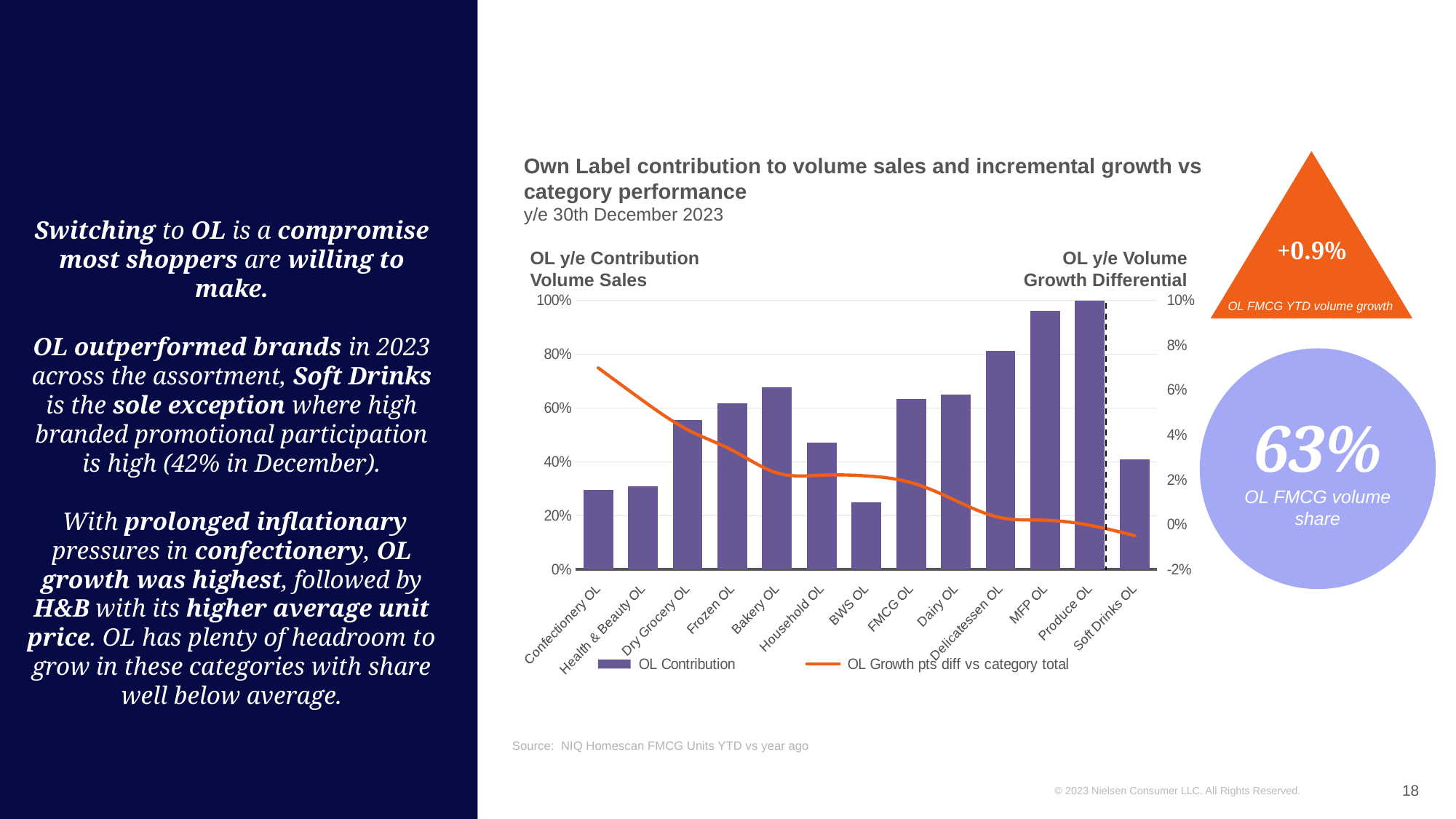
How many categories are shown on the x axis of the chart? 13 Is the OL Contribution for MFP OL greater or less than 80%? greater Which category has the lowest OL Contribution bar? BWS OL Which category has the highest OL Contribution bar? Produce OL What kind of chart is used to show OL Contribution in the 'Own Label contribution to volume sales and incremental growth vs category performance' chart? bar chart How many series does the chart legend list? 2 Does the OL Growth pts diff vs category total line generally rise or fall from Confectionery OL to Soft Drinks OL? fall Which category has the highest value on the OL Growth pts diff vs category total line? Confectionery OL Which has a larger OL Contribution, Bakery OL or Household OL? Bakery OL Is the OL Contribution for Produce OL greater or less than 80%? greater What is the label of the line series in the chart legend? OL Growth pts diff vs category total Is the OL Contribution for BWS OL greater or less than 40%? less